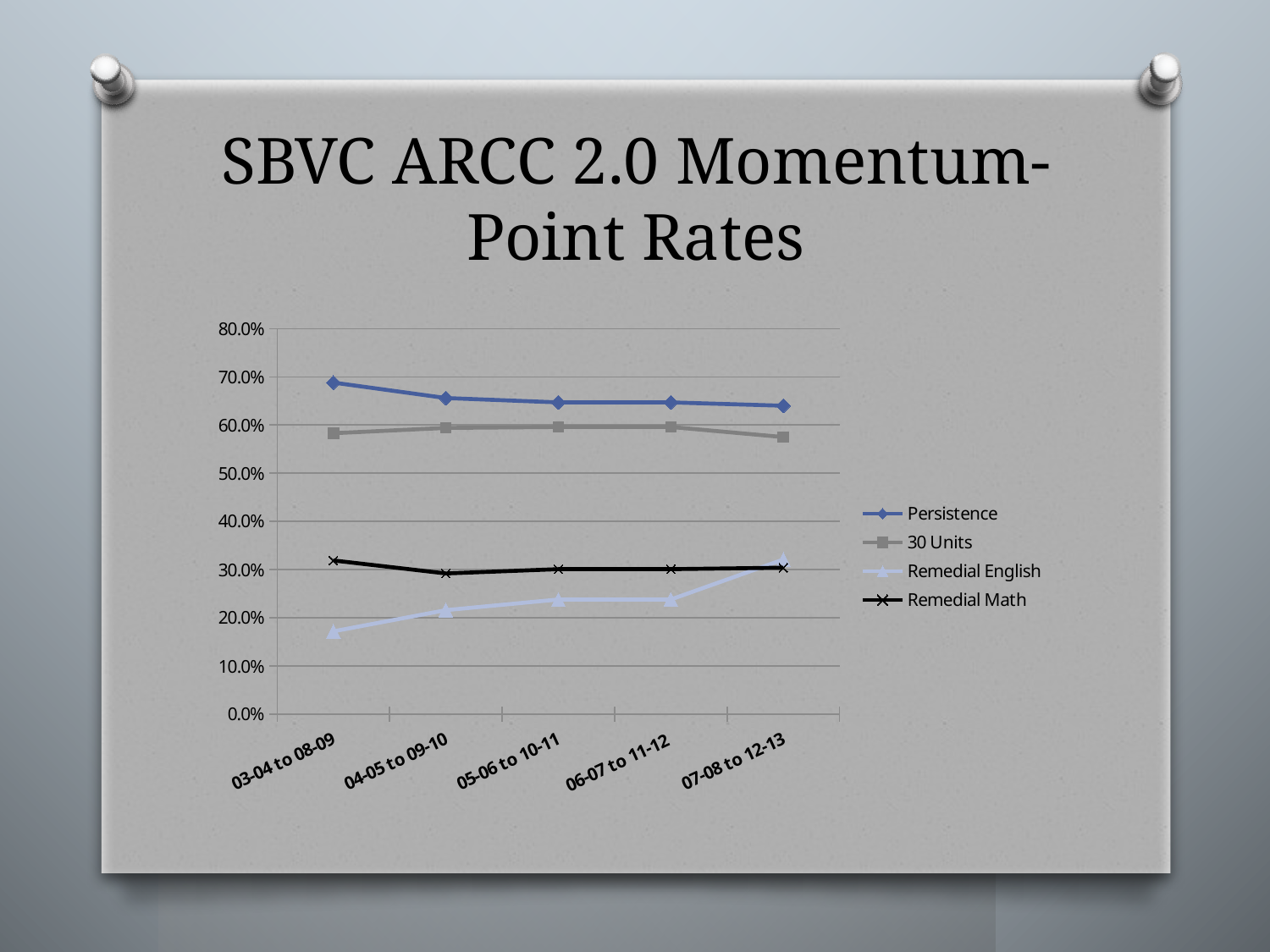
How many cohort periods are plotted along the x axis? 5 Is the 30 Units value for 05-06 to 10-11 greater or less than 50%? greater Is the Remedial English value for 03-04 to 08-09 greater or less than 20%? less Which series has the highest value at 03-04 to 08-09? Persistence What kind of chart is shown on the slide? Line chart Does the Remedial English line rise or fall across the x axis? Rise Is the Persistence value for 03-04 to 08-09 greater or less than 60%? greater At 04-05 to 09-10, which is larger: Remedial Math or Remedial English? Remedial Math Which series has the lowest value at 03-04 to 08-09? Remedial English Does the Persistence line rise or fall from 03-04 to 08-09 through 07-08 to 12-13? Fall How many series does the legend list? 4 At 07-08 to 12-13, which is larger: Persistence or 30 Units? Persistence